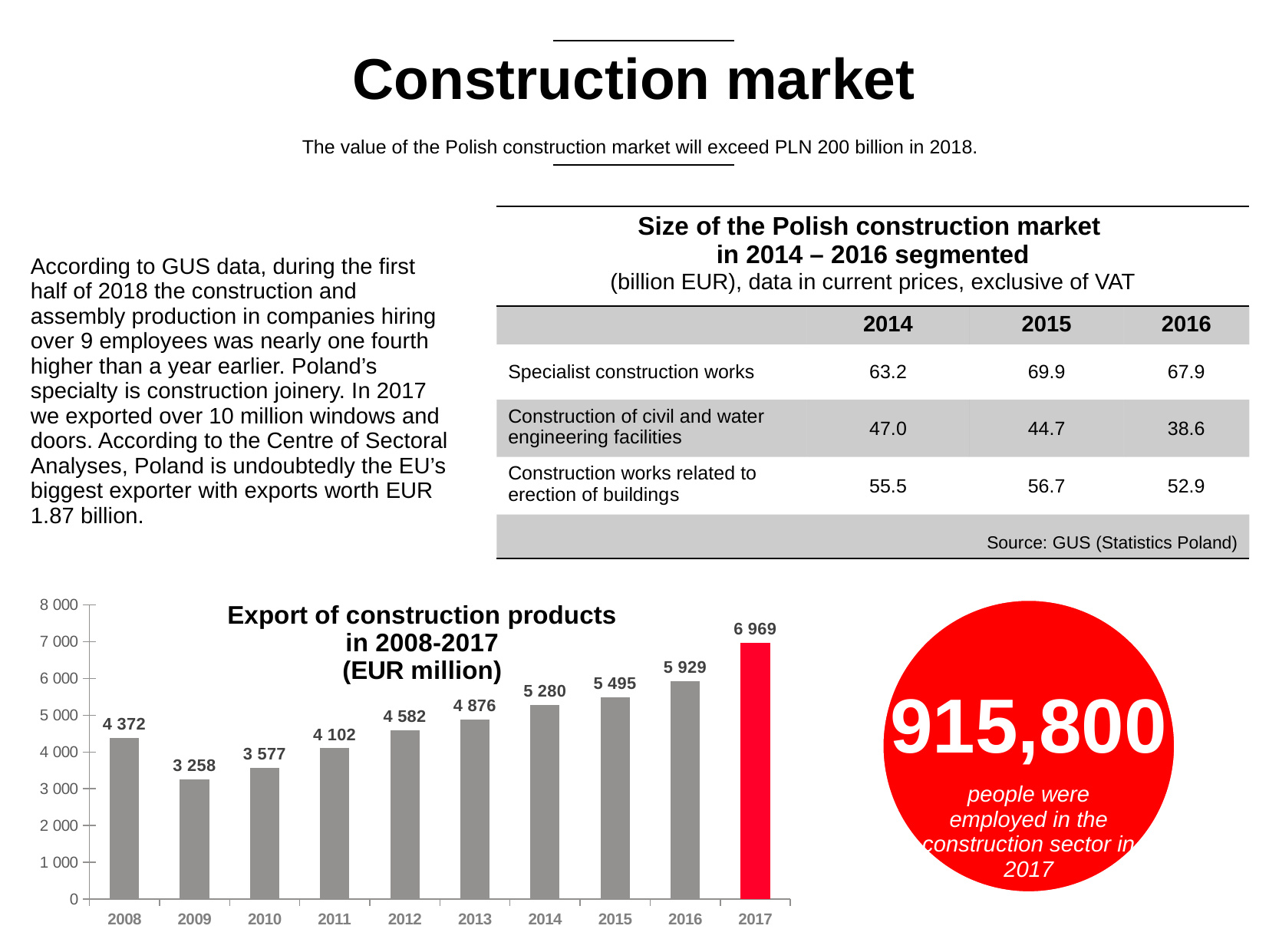
What type of chart is used to show the export of construction products? bar chart Which year has the highest export value of construction products? 2017 What is the export value of construction products in 2013? 4 876 Which year has a larger export value, 2008 or 2011? 2008 What is the export value of construction products in 2017? 6 969 How many years are shown on the export chart? 10 Which year has the lowest export value of construction products? 2009 Is the export value for 2014 greater or less than 5 000? greater What is the export value of construction products in 2009? 3 258 Do export values generally rise or fall from 2009 to 2017? rise What is the difference between the export values in 2008 and 2009? 1 114 What is the difference between the export values in 2017 and 2016? 1 040